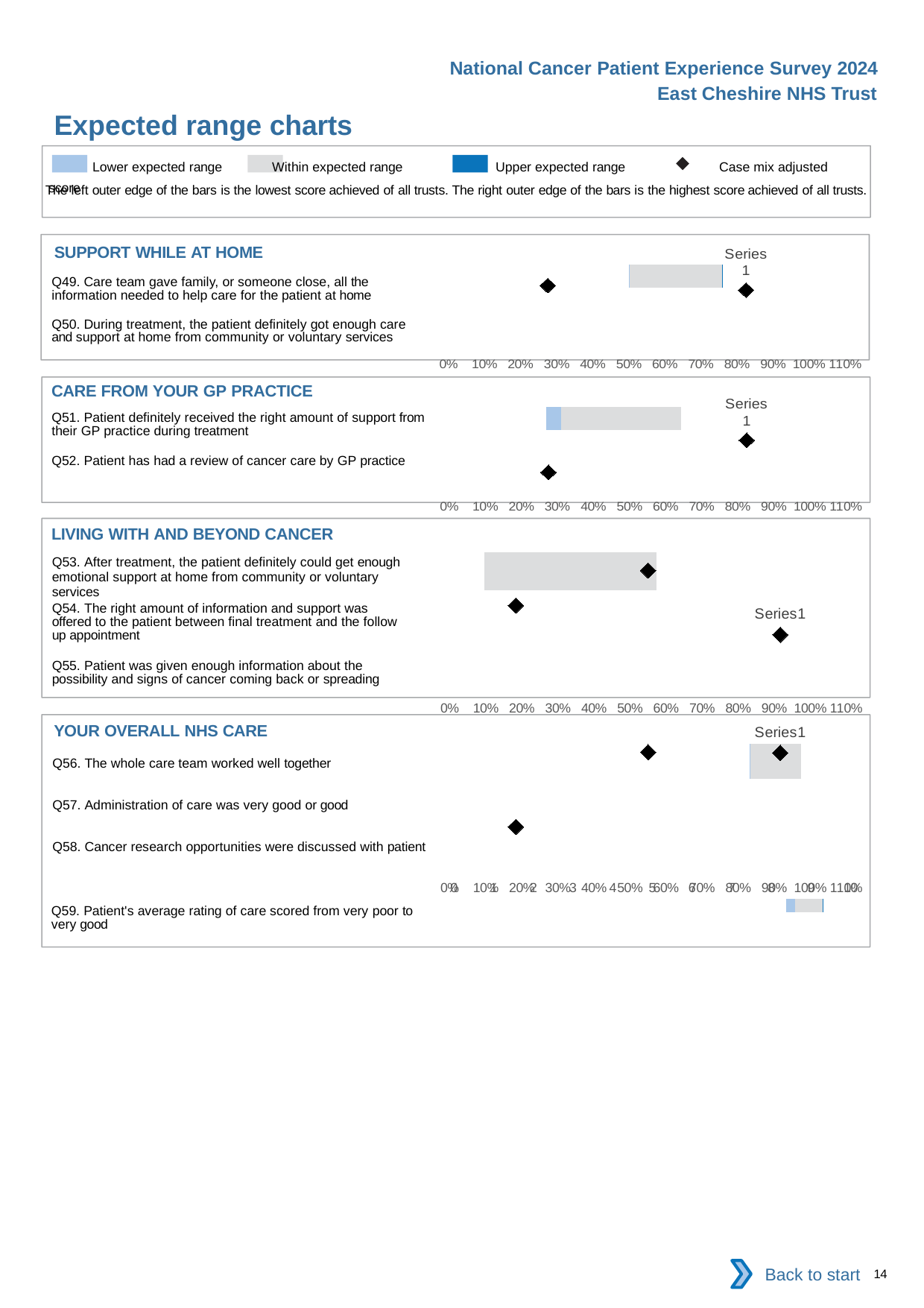
How many questions are listed in the SUPPORT WHILE AT HOME chart? 2 How many entries does the legend at the top of the slide list? 4 How many questions are listed in the CARE FROM YOUR GP PRACTICE chart? 2 In the LIVING WITH AND BEYOND CANCER chart, is the case mix adjusted score for Q53 greater or less than 40%? greater In the YOUR OVERALL NHS CARE chart, is the case mix adjusted score for Q56 greater or less than 40%? greater How many questions are listed in the LIVING WITH AND BEYOND CANCER chart? 3 What is the title of the slide? Expected range charts What kind of chart is used in the SUPPORT WHILE AT HOME section? bar chart What is the highest tick shown on the x axis of the SUPPORT WHILE AT HOME chart? 110%